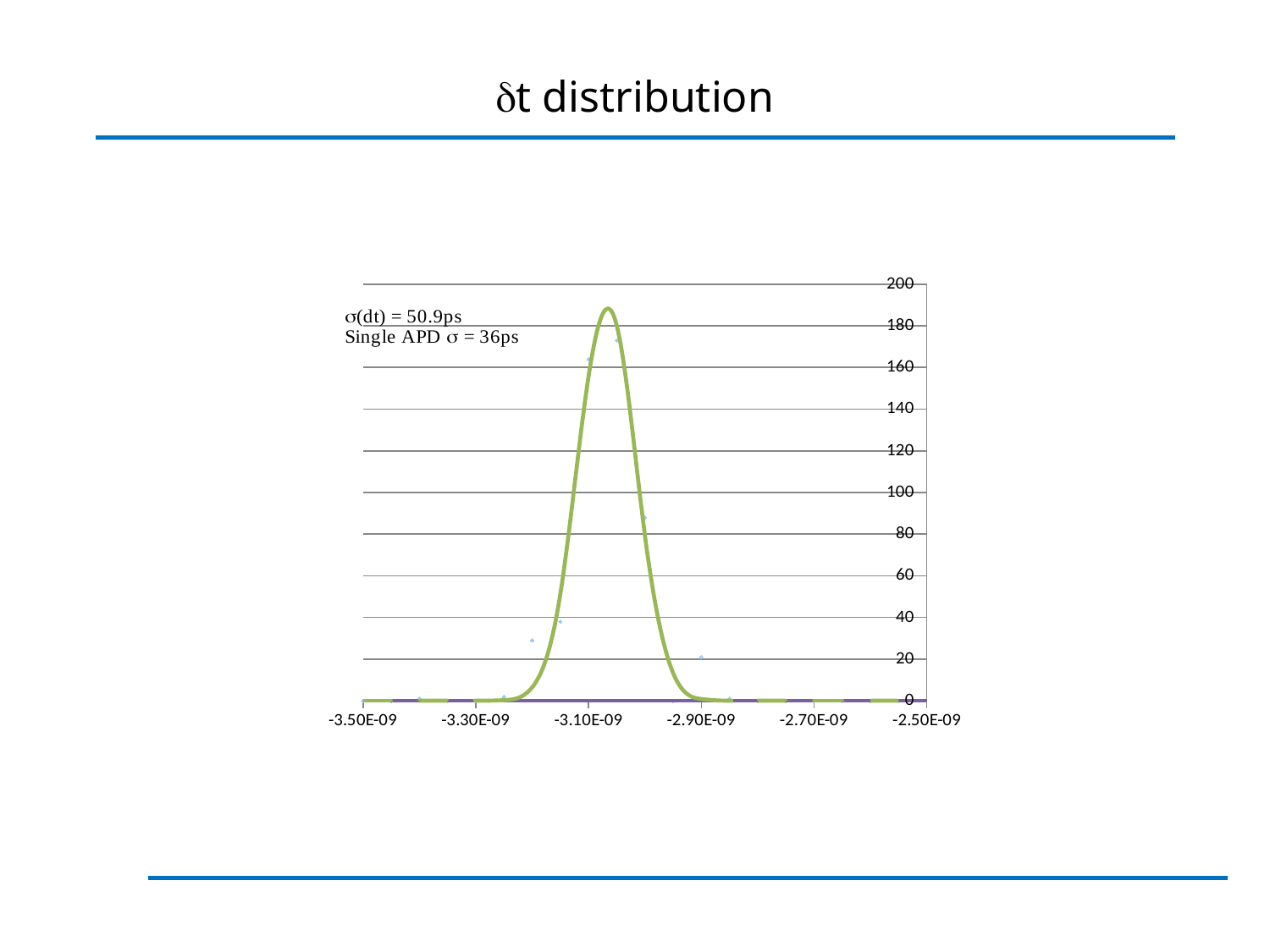
What kind of chart is shown on the slide? line chart What is the maximum value shown on the y axis? 200 Is the value of the curve at -2.70E-09 greater or less than 20? less What is the title of the slide containing the chart? δt distribution Does the curve rise or fall between -3.00E-09 and -2.90E-09 on the x axis? fall Near which x-axis tick does the peak of the distribution occur? -3.10E-09 Is the value of the curve at -3.30E-09 greater or less than 20? less Is the peak value of the fitted curve greater or less than 200? less What value of σ(dt) is annotated on the chart? 50.9ps Does the curve rise or fall between -3.30E-09 and -3.10E-09 on the x axis? rise What single APD σ value is annotated on the chart? 36ps